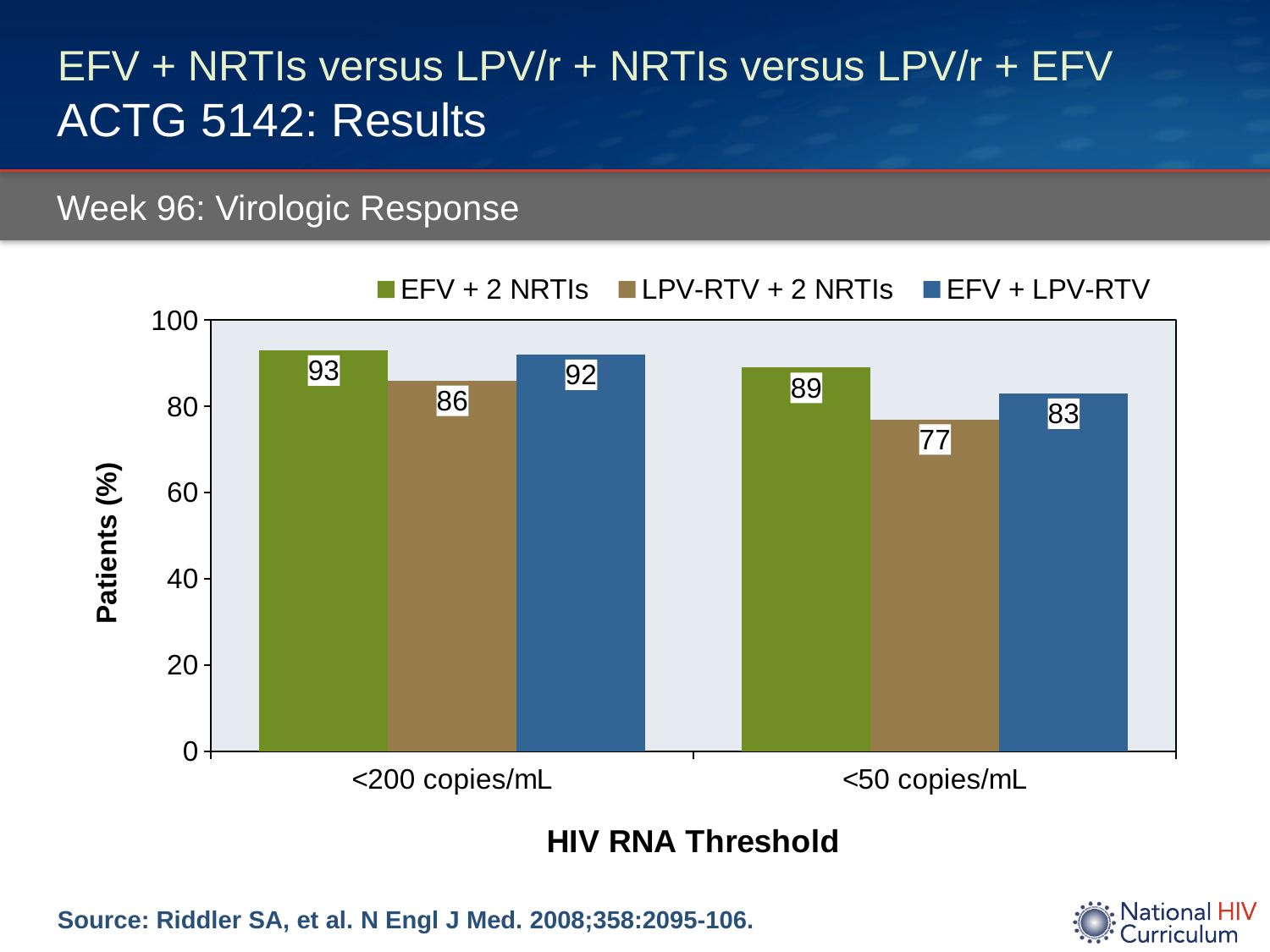
What percentage of patients in the EFV + 2 NRTIs group had HIV RNA <200 copies/mL? 93 How many HIV RNA threshold categories are shown on the x axis? 2 What kind of chart is shown on the slide? Bar chart Which is larger: the LPV-RTV + 2 NRTIs value at <200 copies/mL or the EFV + LPV-RTV value at <50 copies/mL? LPV-RTV + 2 NRTIs at <200 copies/mL Which treatment group has the lowest value at the <50 copies/mL threshold? LPV-RTV + 2 NRTIs Which treatment group has the highest value at the <200 copies/mL threshold? EFV + 2 NRTIs What is the label of the y axis? Patients (%) How many series does the legend list? 3 What is the value for EFV + LPV-RTV at the <200 copies/mL threshold? 92 What is the value for LPV-RTV + 2 NRTIs at the <50 copies/mL threshold? 77 What is the difference between the EFV + LPV-RTV values at <200 copies/mL and <50 copies/mL? 9 What is the difference between the EFV + 2 NRTIs and LPV-RTV + 2 NRTIs values at the <50 copies/mL threshold? 12